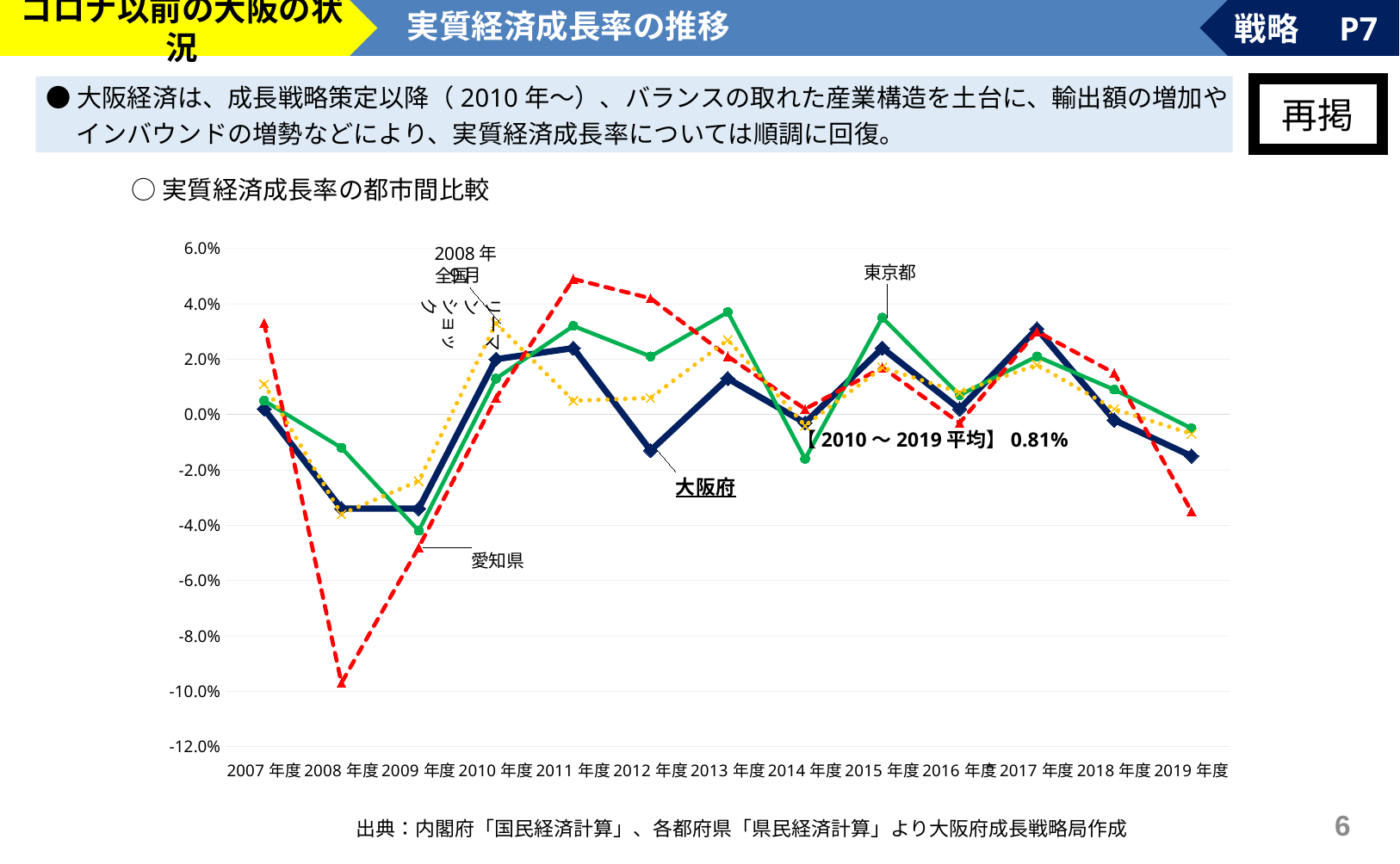
Is the value for 愛知県 in 2019年度 greater or less than -2.0%? less What kind of chart is shown on the slide? line chart In 2014年度, which has the higher growth rate, 大阪府 or 東京都? 大阪府 Is the value for 東京都 in 2013年度 greater or less than 2.0%? greater Is the value for 大阪府 in 2012年度 greater or less than 0.0%? less From 2017年度 to 2019年度, does the line for 大阪府 rise or fall? fall How many fiscal years are plotted along the x axis of the chart? 13 Which prefecture has the highest real economic growth rate in 2011年度? 愛知県 In 2012年度, which has the higher growth rate, 大阪府 or 東京都? 東京都 Which prefecture has the lowest real economic growth rate in 2008年度? 愛知県 What 2010–2019 average value is annotated on the chart? 0.81%